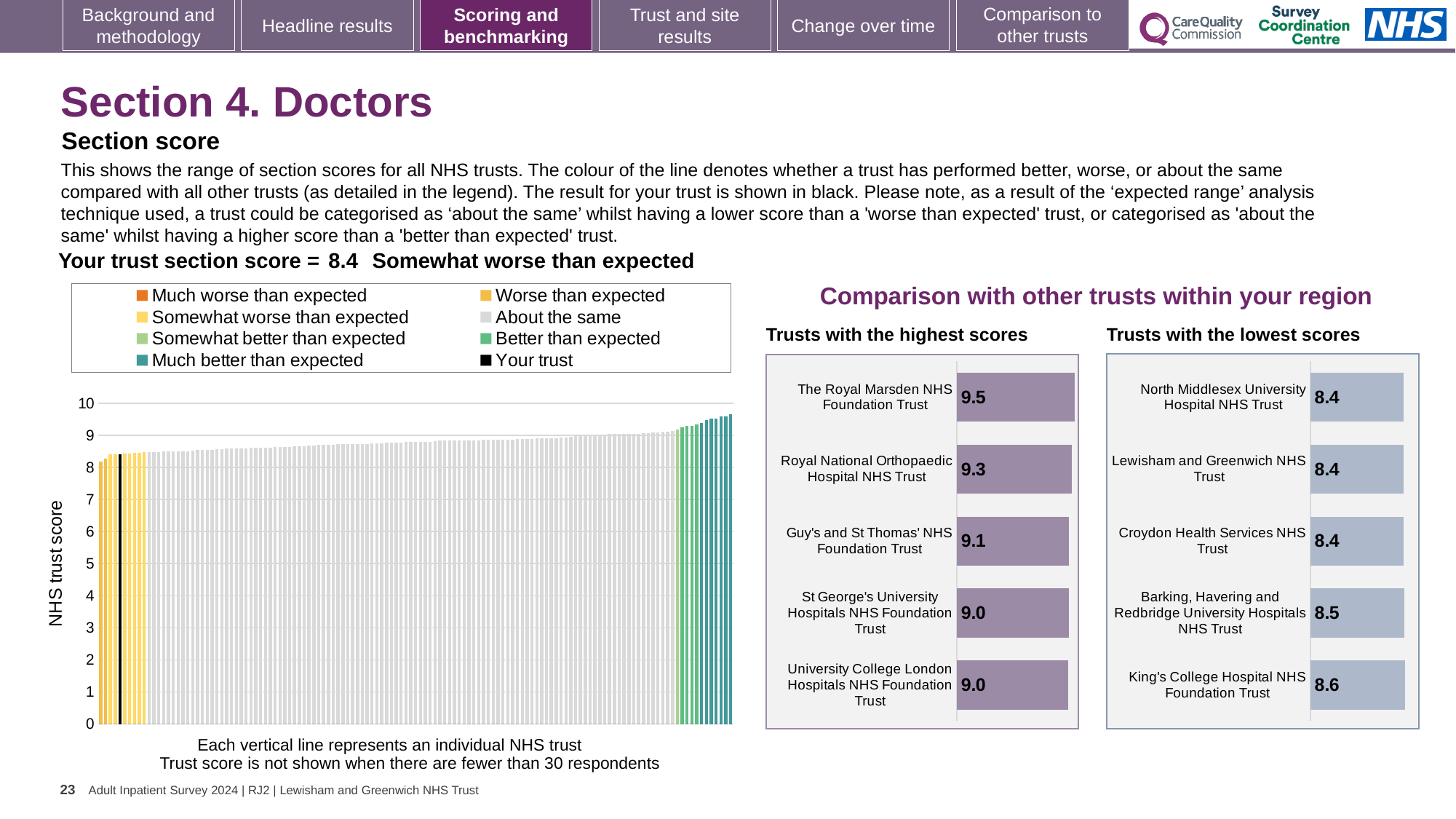
In the 'Trusts with the lowest scores' chart, which is larger: the score for King's College Hospital NHS Foundation Trust or Croydon Health Services NHS Trust? King's College Hospital NHS Foundation Trust In the main 'NHS trust score' chart, what is the section score for your trust? 8.4 In the 'Trusts with the lowest scores' chart, what is the score for King's College Hospital NHS Foundation Trust? 8.6 In the 'Trusts with the highest scores' chart, how many trusts are shown? 5 In the 'Trusts with the highest scores' chart, which trust has the highest score? The Royal Marsden NHS Foundation Trust In the 'Trusts with the lowest scores' chart, which trust has the highest score? King's College Hospital NHS Foundation Trust In the 'Trusts with the highest scores' chart, what is the difference between the scores of The Royal Marsden NHS Foundation Trust and Royal National Orthopaedic Hospital NHS Trust? 0.2 In the 'Trusts with the highest scores' chart, what is the score for Guy's and St Thomas' NHS Foundation Trust? 9.1 How many entries does the legend of the main 'NHS trust score' chart list? 8 What kind of chart is the main 'NHS trust score' chart? Bar chart In the 'Trusts with the highest scores' chart, what is the score for The Royal Marsden NHS Foundation Trust? 9.5 In the 'Trusts with the lowest scores' chart, what is the score for Barking, Havering and Redbridge University Hospitals NHS Trust? 8.5